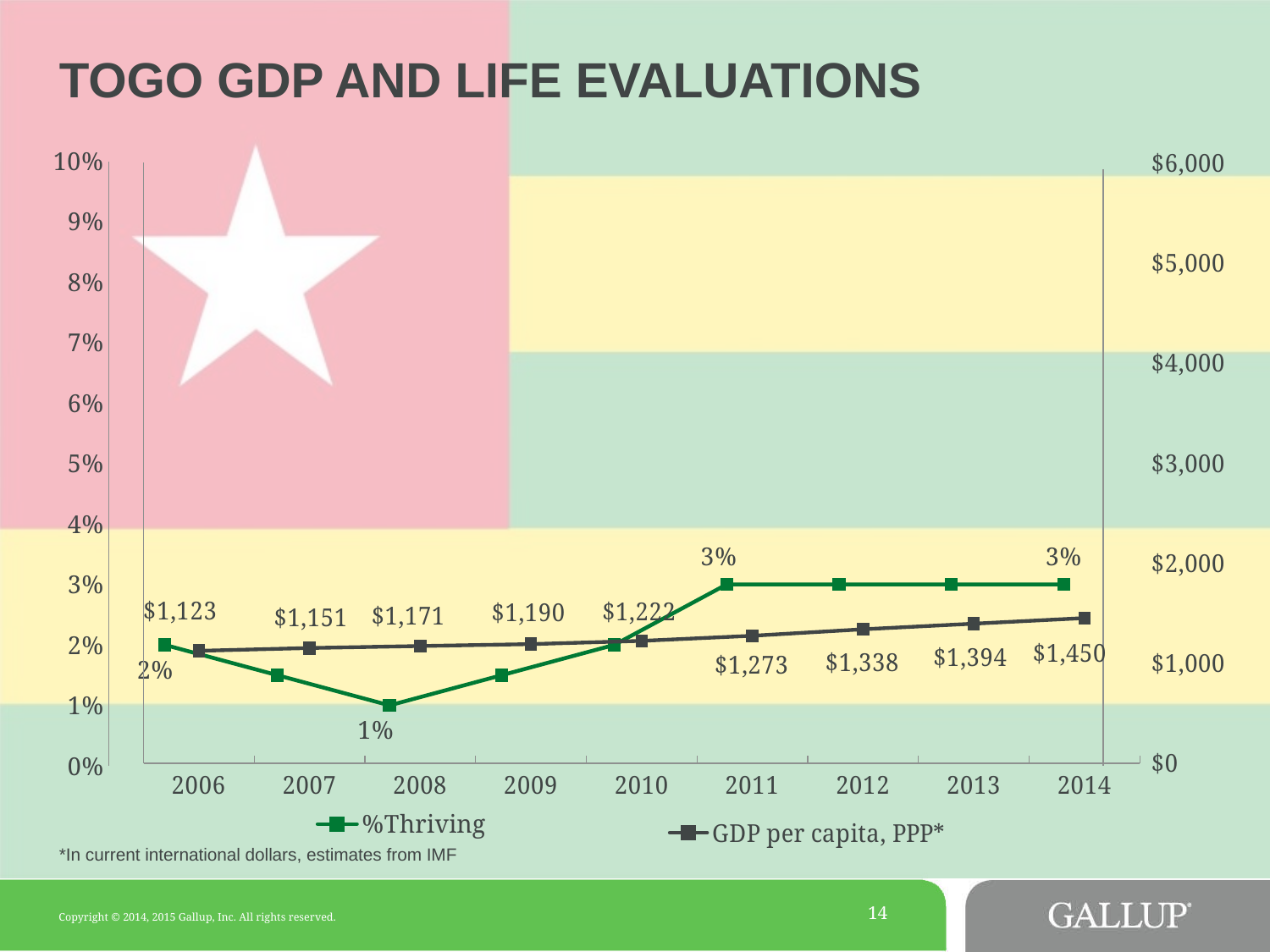
In which year is %Thriving lowest? 2008 Is the %Thriving value for 2007 greater or less than 2%? less How many years are shown on the x axis? 9 What is the %Thriving value for 2008? 1% What is the %Thriving value for 2011? 3% What is the difference between GDP per capita, PPP in 2014 and in 2006? $327 Which year has the higher GDP per capita, PPP: 2010 or 2011? 2011 In which year is GDP per capita, PPP highest? 2014 Does GDP per capita, PPP rise or fall from 2006 to 2014? rise What is the GDP per capita, PPP value for 2006? $1,123 What is the GDP per capita, PPP value for 2014? $1,450 How many series does the legend list? 2